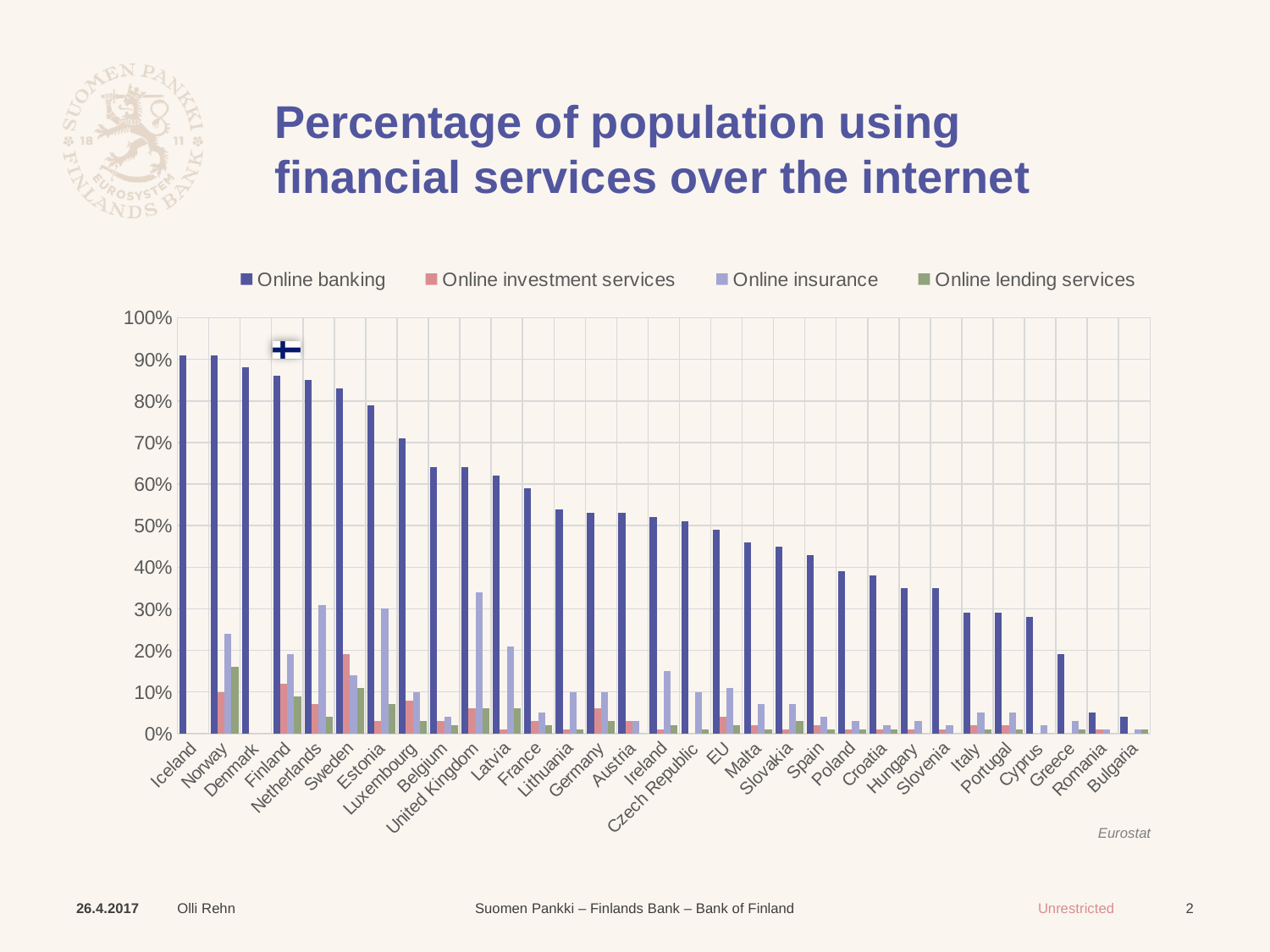
Is the Online banking value for Greece greater or less than 30%? less Is the Online banking value for Estonia greater or less than 70%? greater Which has the larger Online banking value, Denmark or Sweden? Denmark Is the Online banking value for Finland greater or less than 80%? greater What kind of chart is shown on the slide? bar chart Do the Online banking values generally rise or fall moving from left to right along the x axis? fall Which has the larger Online insurance value, Norway or the Netherlands? Netherlands How many countries/categories are shown on the x axis? 31 How many series does the legend list? 4 What source is cited below the chart? Eurostat